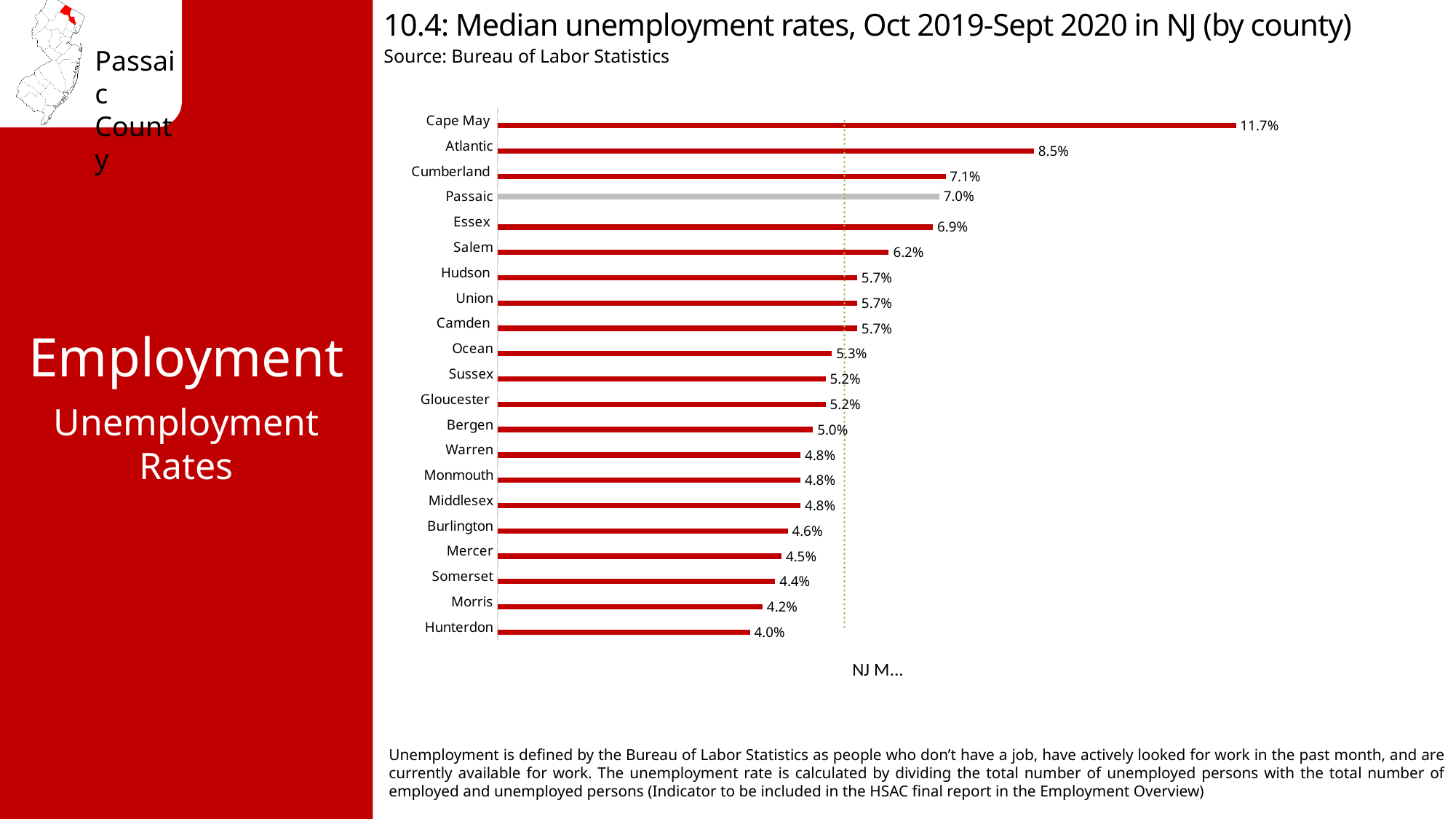
What is the difference between the median unemployment rates of Passaic and Hunterdon counties? 3.0% Which county has the lowest median unemployment rate? Hunterdon Which county's bar is shown in grey rather than red? Passaic Which county has the highest median unemployment rate? Cape May What is the median unemployment rate for Cape May county? 11.7% What is the median unemployment rate for Bergen county? 5.0% Which county has a higher median unemployment rate, Essex or Salem? Essex What is the median unemployment rate for Hunterdon county? 4.0% What is the median unemployment rate for Passaic county? 7.0% What type of chart is used to show the median unemployment rates? Bar chart How many counties are shown in the chart? 21 What is the difference between the median unemployment rates of Cape May and Atlantic counties? 3.2%